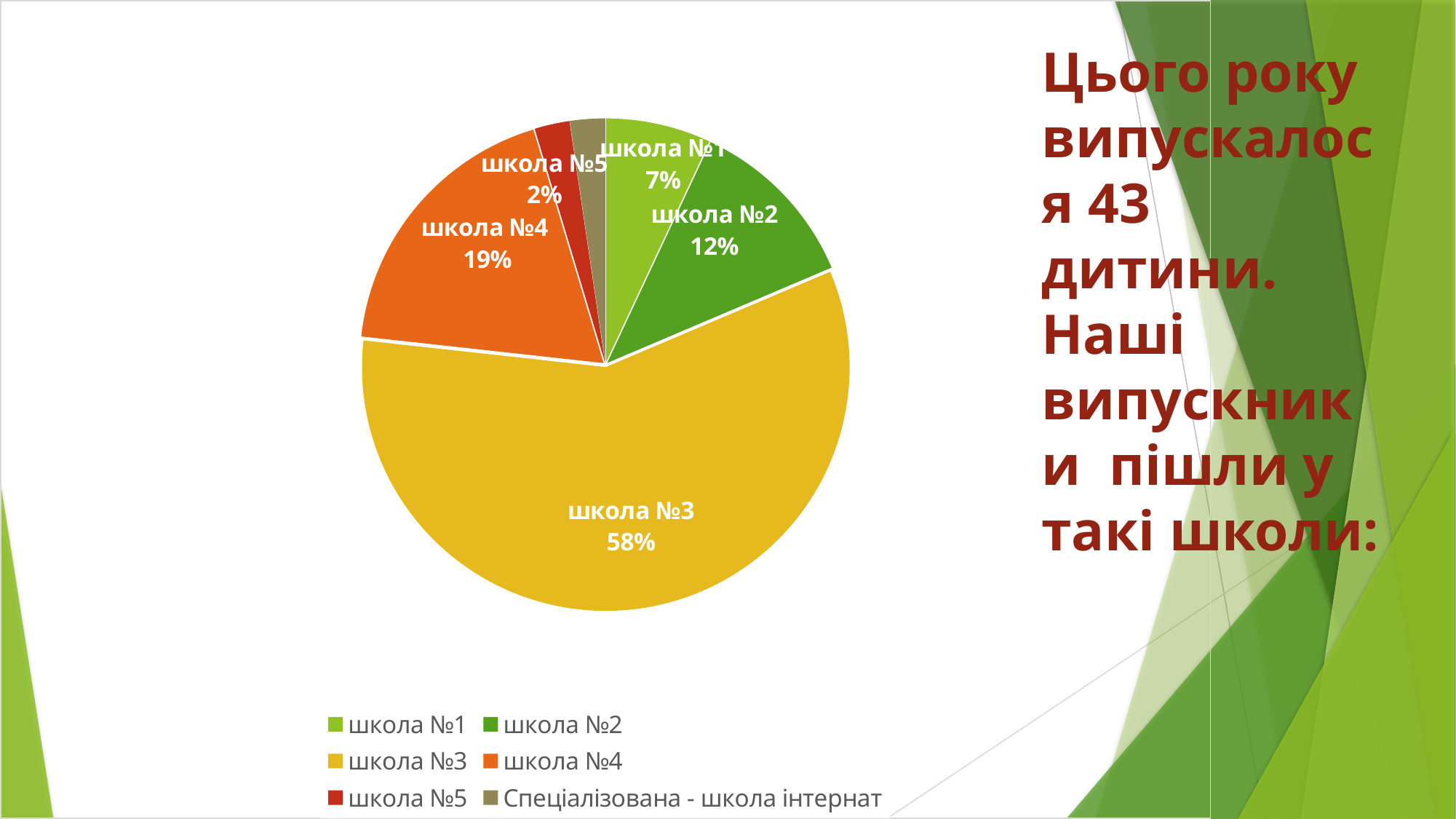
What is the difference in percentage points between школа №4 and школа №2? 7 Which school has the largest share of the pie chart? школа №3 What percentage of the pie chart is школа №2? 12% What percentage of the pie chart is школа №3? 58% Which legend entry is shown in a brownish-grey colour? Спеціалізована - школа інтернат What percentage of the pie chart is школа №4? 19% How many entries does the legend of the pie chart list? 6 Which has a larger share, школа №2 or школа №1? школа №2 What is the difference in percentage points between школа №3 and школа №4? 39 What percentage of the pie chart is школа №5? 2% What type of chart is shown on the slide? pie chart What percentage of the pie chart is школа №1? 7%